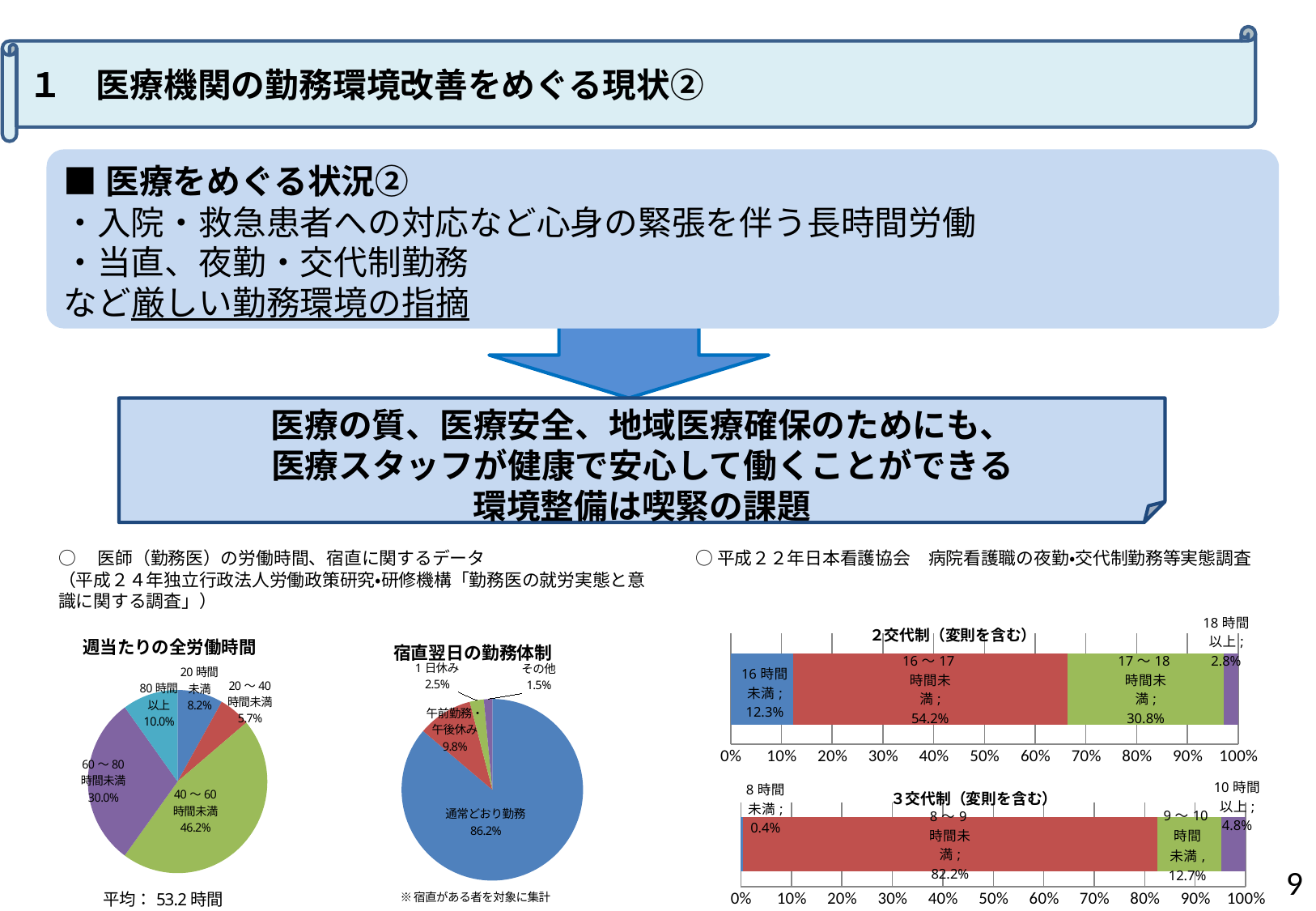
In the pie chart titled 週当たりの全労働時間, how many categories are shown? 5 What kind of chart is the chart titled 宿直翌日の勤務体制? pie chart In the bar chart titled 2交代制（変則を含む）, what value is labelled for 16～17時間未満? 54.2% In the pie chart titled 週当たりの全労働時間, what share is labelled for 40～60時間未満? 46.2% In the bar chart titled 2交代制（変則を含む）, which segment is the smallest? 18時間以上 In the pie chart titled 週当たりの全労働時間, what is the difference between the shares for 60～80時間未満 and 80時間以上? 20.0% In the pie chart titled 週当たりの全労働時間, which category has the smallest share? 20～40時間未満 In the bar chart titled 3交代制（変則を含む）, what is the difference between the values for 8～9時間未満 and 10時間以上? 77.4% In the bar chart titled 3交代制（変則を含む）, what value is labelled for 9～10時間未満? 12.7% In the pie chart titled 宿直翌日の勤務体制, what share is labelled for 通常どおり勤務? 86.2% In the pie chart titled 週当たりの全労働時間, which category has the largest share? 40～60時間未満 In the pie chart titled 宿直翌日の勤務体制, which is larger: 午前勤務・午後休み or 1日休み? 午前勤務・午後休み